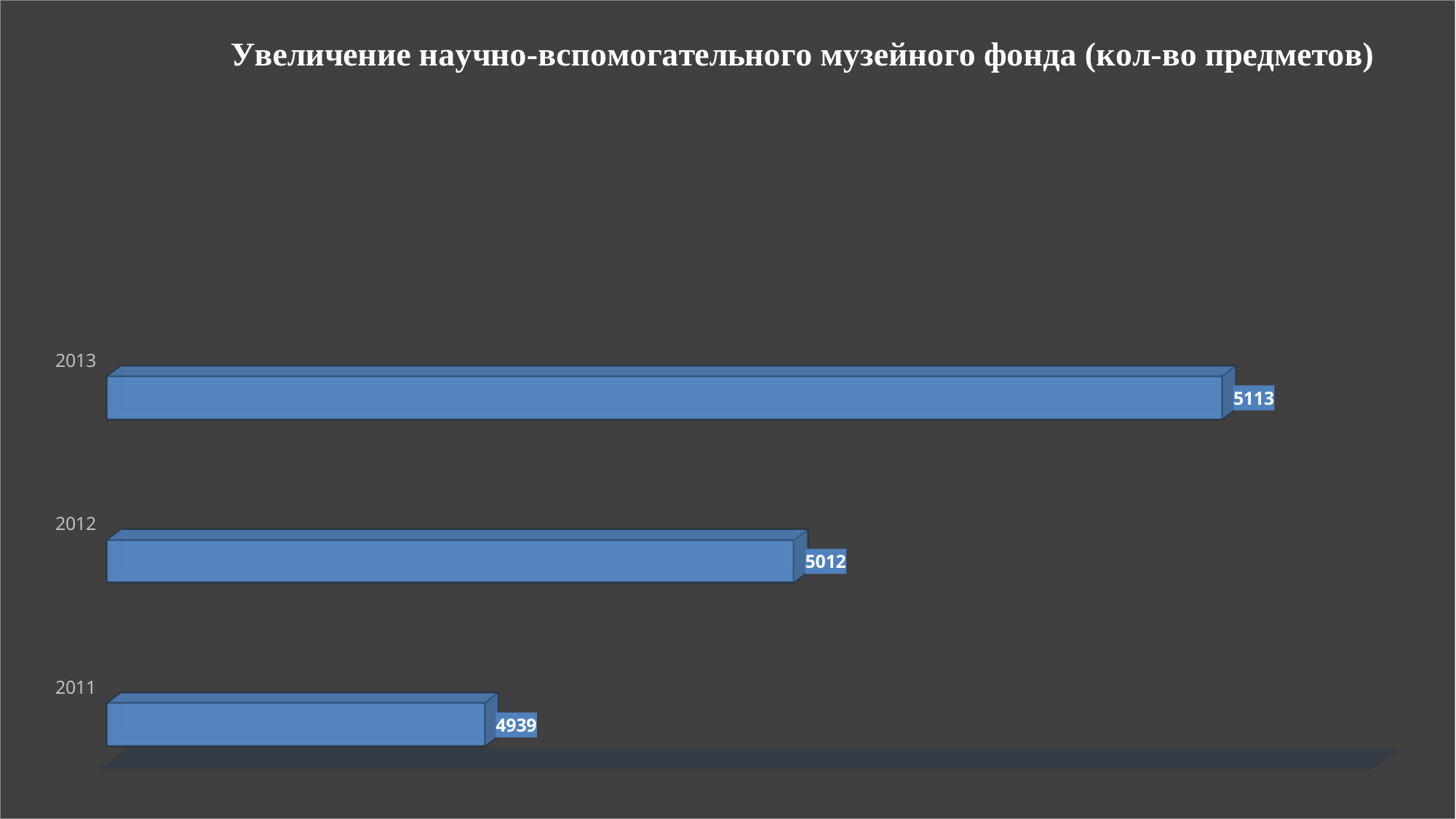
What kind of chart is shown on the slide? bar chart What is the title of the chart? Увеличение научно-вспомогательного музейного фонда (кол-во предметов) What is the value for 2013? 5113 Which year has the lowest value? 2011 Which year has the highest value? 2013 Which is larger, the value for 2012 or the value for 2011? 2012 What is the value for 2012? 5012 What is the value for 2011? 4939 What is the difference between the values for 2013 and 2012? 101 How many years are shown in the chart? 3 What is the difference between the values for 2012 and 2011? 73 What is the difference between the values for 2013 and 2011? 174